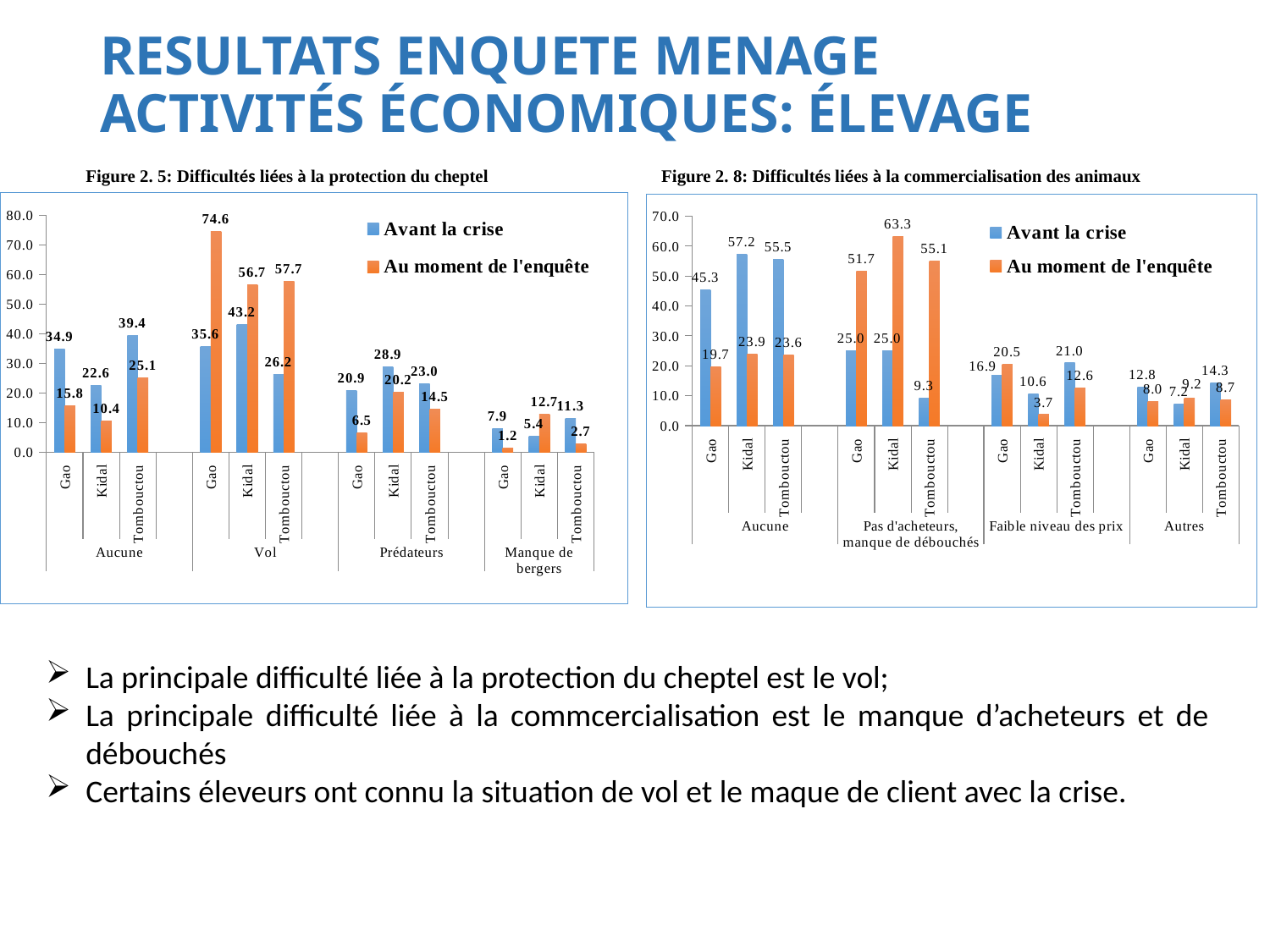
In Figure 2.8 (Difficultés liées à la commercialisation des animaux), how many difficulty categories are shown on the x axis? 4 In Figure 2.5 (Difficultés liées à la protection du cheptel), what is the value for Gao under Vol for 'Au moment de l'enquête'? 74.6 In Figure 2.8 (Difficultés liées à la commercialisation des animaux), which is larger for Tombouctou under 'Pas d'acheteurs, manque de débouchés': 'Avant la crise' or 'Au moment de l'enquête'? Au moment de l'enquête In Figure 2.5 (Difficultés liées à la protection du cheptel), what is the difference between 'Au moment de l'enquête' and 'Avant la crise' for Kidal under Vol? 13.5 In Figure 2.8 (Difficultés liées à la commercialisation des animaux), what is the value for Kidal under 'Pas d'acheteurs, manque de débouchés' for 'Au moment de l'enquête'? 63.3 In Figure 2.8 (Difficultés liées à la commercialisation des animaux), what is the value for Kidal under Aucune for 'Avant la crise'? 57.2 In Figure 2.5 (Difficultés liées à la protection du cheptel), how many series does the legend list? 2 In Figure 2.5 (Difficultés liées à la protection du cheptel), what is the lowest value shown in the chart? 1.2 In Figure 2.5 (Difficultés liées à la protection du cheptel), what is the value for Tombouctou under Aucune for 'Avant la crise'? 39.4 In Figure 2.8 (Difficultés liées à la commercialisation des animaux), what is the difference between 'Avant la crise' and 'Au moment de l'enquête' for Gao under Aucune? 25.6 In Figure 2.5 (Difficultés liées à la protection du cheptel), which bar has the highest value in the whole chart? Gao, Vol, Au moment de l'enquête (74.6) What type of chart is Figure 2.8 (Difficultés liées à la commercialisation des animaux)? Bar chart